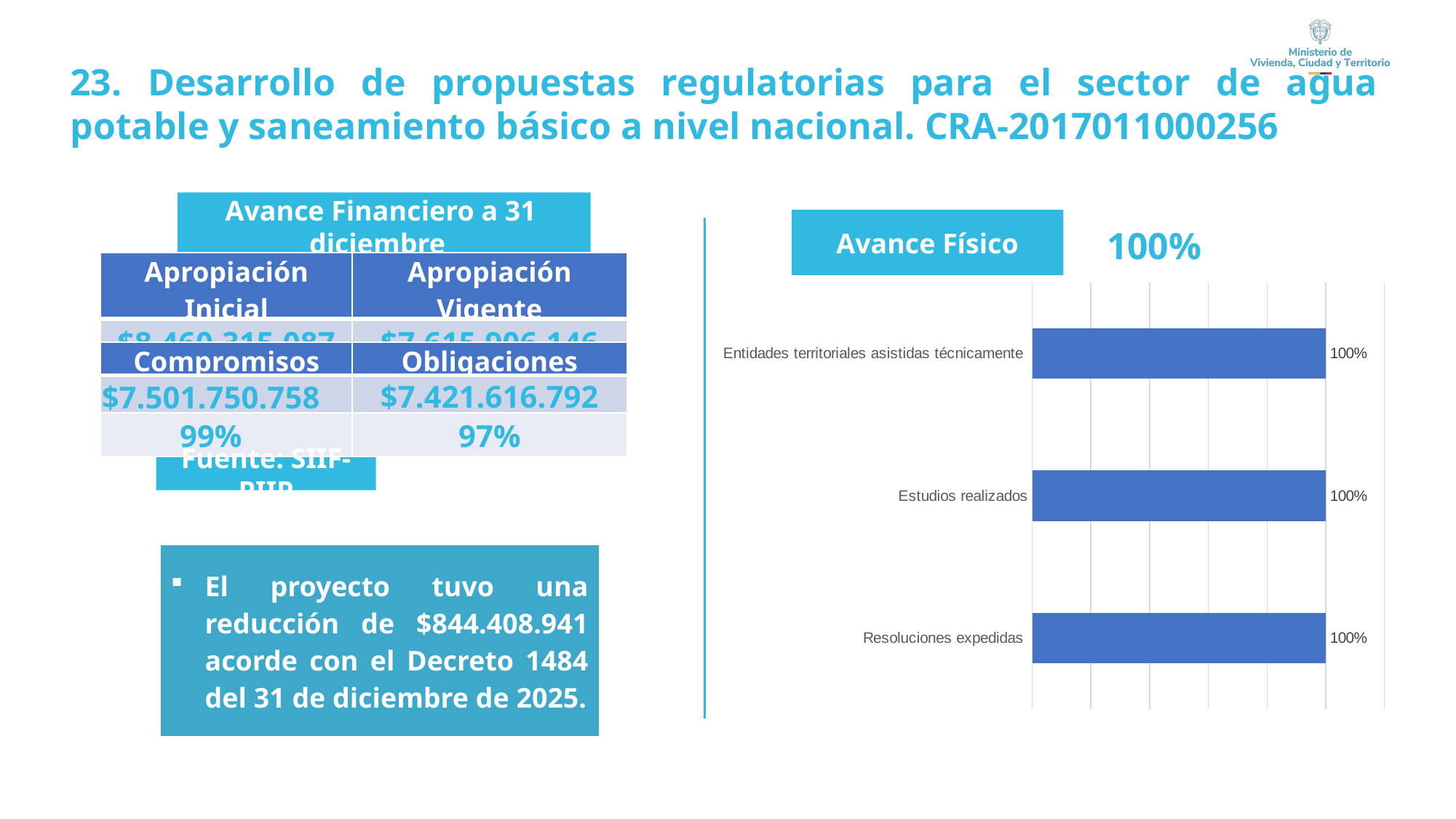
How many categories does the chart show? 3 What is the value for Resoluciones expedidas? 100% What is the difference between the values for Estudios realizados and Resoluciones expedidas? 0% What kind of chart is shown on the slide? Bar chart What is the title shown above the chart? Avance Físico Are the bars in the chart horizontal or vertical? Horizontal What is the value for Entidades territoriales asistidas técnicamente? 100% What is the value for Estudios realizados? 100% Do the values differ across the three categories, or are they all the same? All the same